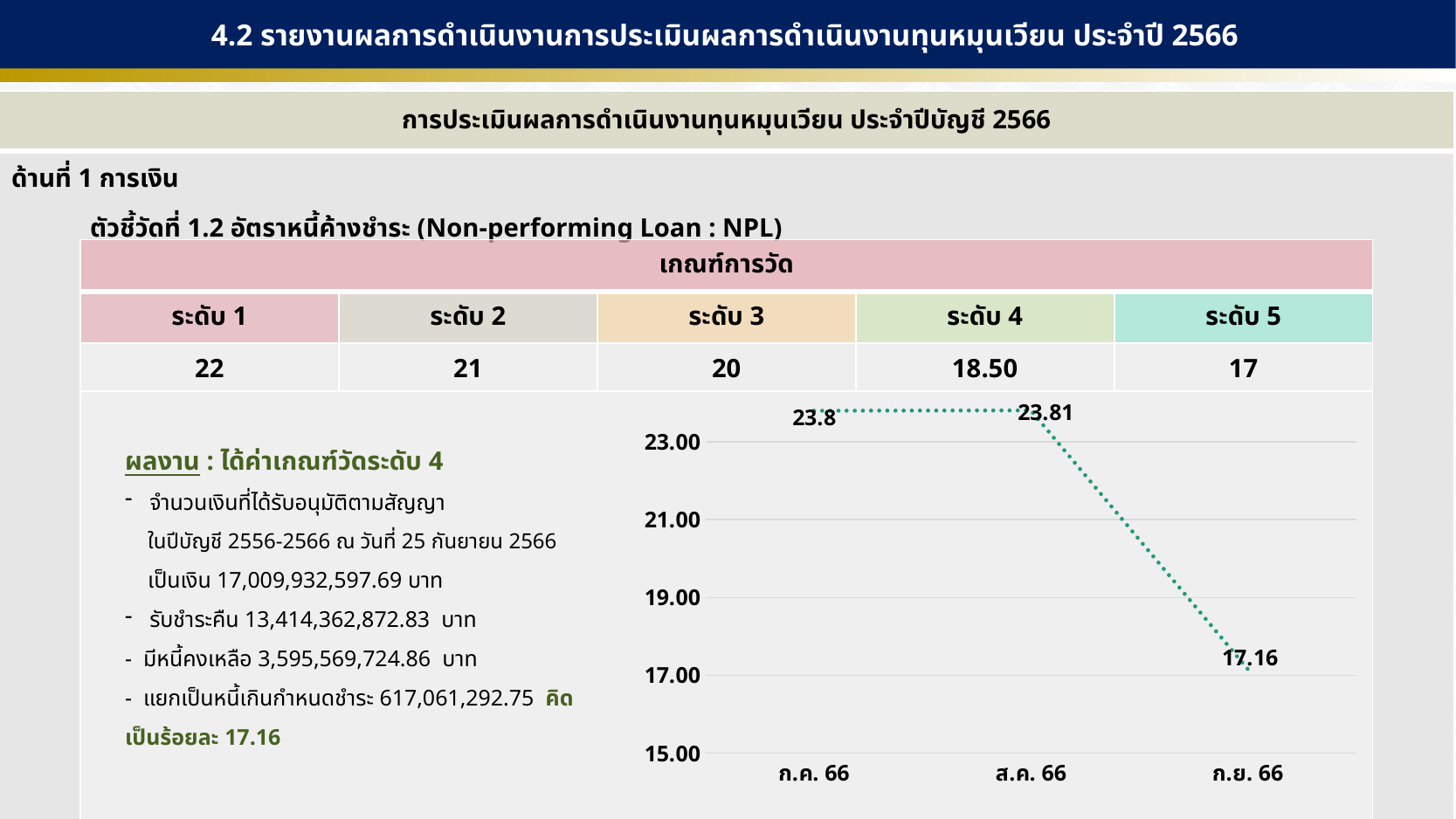
Do the values rise or fall from ส.ค. 66 to ก.ย. 66? fall What is the difference between the values for ก.ค. 66 and ก.ย. 66? 6.64 Is the value for ส.ค. 66 greater or less than 23.00? greater What is the value for ก.ย. 66? 17.16 How many data points are plotted on the chart? 3 What kind of chart is shown? line chart Which month has the lowest value? ก.ย. 66 Which is larger, the value for ก.ค. 66 or the value for ก.ย. 66? ก.ค. 66 What is the value for ก.ค. 66? 23.8 Is the value for ก.ย. 66 greater or less than 19.00? less What is the value for ส.ค. 66? 23.81 What is the difference between the values for ส.ค. 66 and ก.ย. 66? 6.65